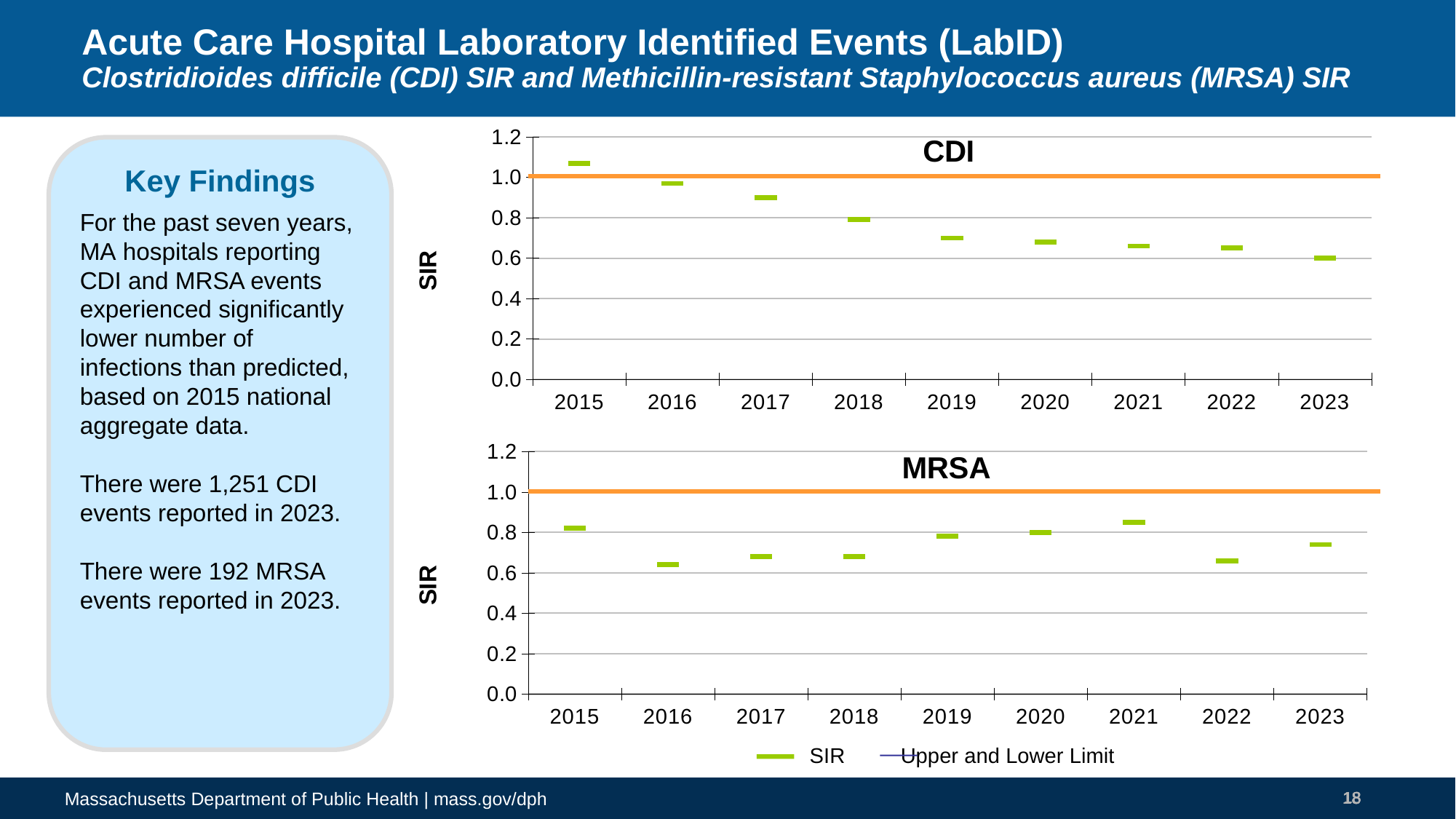
How many years are plotted on the x axis of the MRSA chart? 9 In the CDI chart, is the SIR value for 2023 greater or less than 0.8? less In the MRSA chart, is the SIR value for 2016 greater or less than 0.8? less In the MRSA chart, which year has the larger SIR value, 2015 or 2022? 2015 How many series does the legend below the MRSA chart list? 2 In the CDI chart, do the SIR values generally rise or fall from 2015 to 2023? fall In the CDI chart, which year has the highest SIR value? 2015 In the CDI chart, which year has the larger SIR value, 2016 or 2019? 2016 In the MRSA chart, is the SIR value for 2021 greater or less than 0.8? greater In the CDI chart, which year has the lowest SIR value? 2023